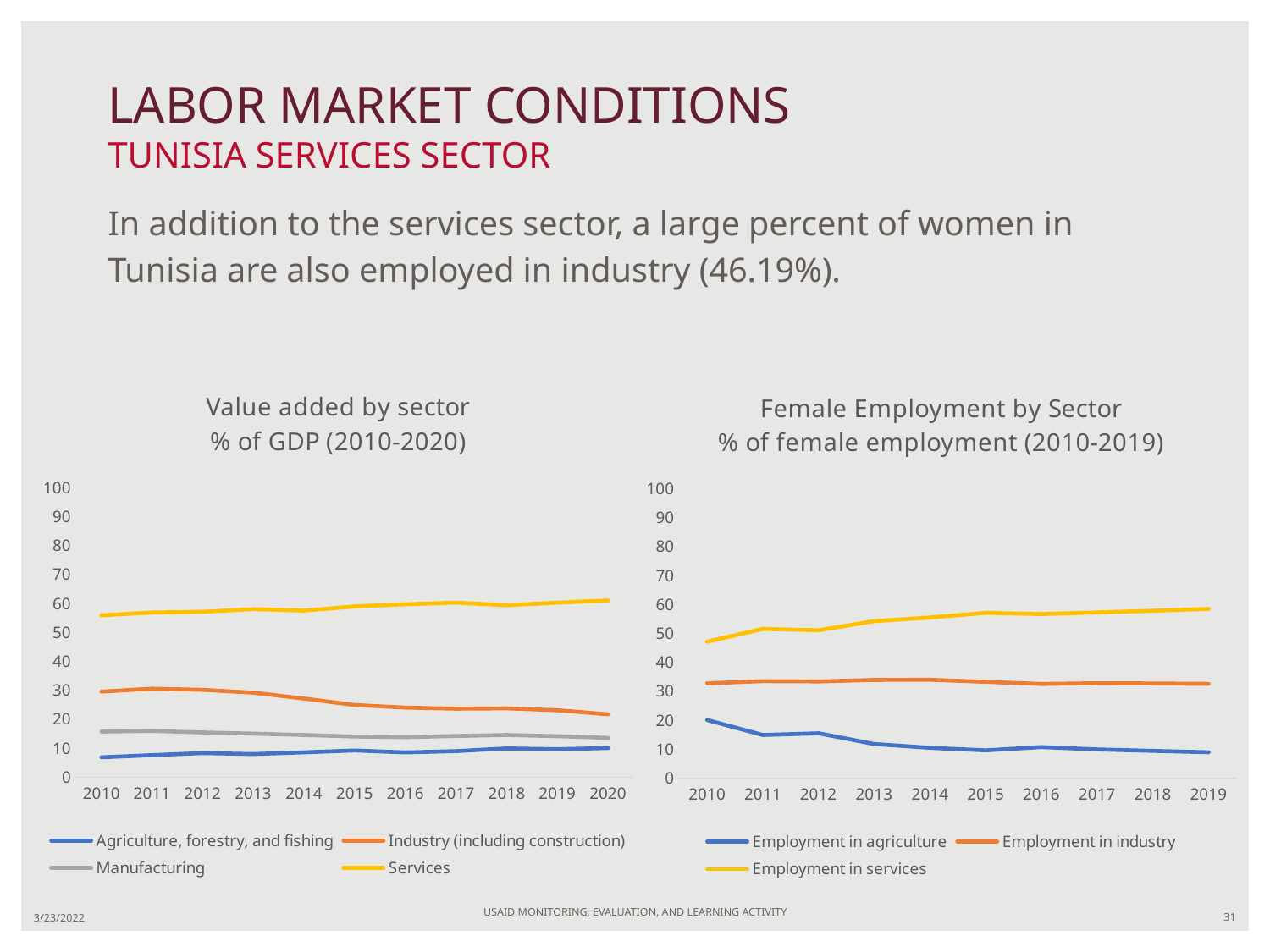
In the 'Value added by sector' chart, does the Industry (including construction) line rise or fall from 2010 to 2020? fall In the 'Value added by sector' chart, which series has the highest values across all years? Services In the 'Value added by sector' chart, is the value for Industry (including construction) in 2020 greater or less than 30? less What kind of chart is the 'Value added by sector' chart on the left? line chart In the 'Value added by sector' chart, which series has the lowest values across all years? Agriculture, forestry, and fishing In the 'Female Employment by Sector' chart, which is larger in 2019: Employment in industry or Employment in agriculture? Employment in industry How many series does the legend of the 'Female Employment by Sector' chart list? 3 In the 'Female Employment by Sector' chart, is the value for Employment in services in 2010 greater or less than 50? less How many years are plotted on the x axis of the 'Value added by sector' chart? 11 In the 'Female Employment by Sector' chart, does the Employment in agriculture line rise or fall from 2010 to 2019? fall How many years are plotted on the x axis of the 'Female Employment by Sector' chart? 10 How many series does the legend of the 'Value added by sector' chart list? 4